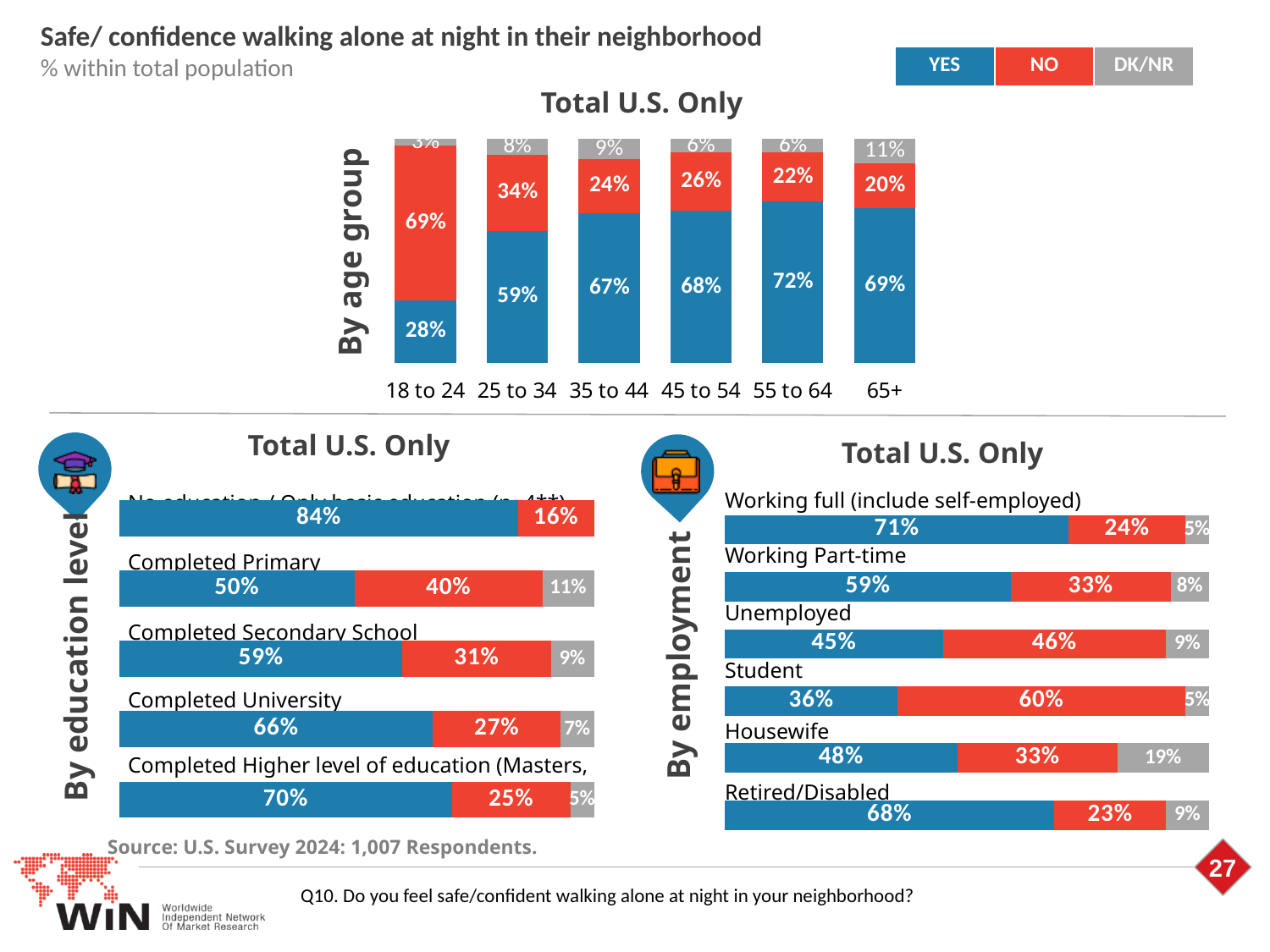
In the 'By education level' chart, which has the larger YES percentage: Completed Primary or Completed Secondary School? Completed Secondary School In the 'By education level' chart, what percentage of those who Completed University answered YES? 66% In the 'By age group' chart, what percentage of the 18 to 24 age group answered NO? 69% In the 'By employment' chart, which employment category has the highest DK/NR percentage? Housewife What kind of chart is the 'By age group' chart? Stacked bar chart How many series does the legend at the top of the slide list? 3 In the 'By age group' chart, which age group has the highest YES percentage? 55 to 64 In the 'By employment' chart, what is the difference between the YES percentage for Working full (include self-employed) and Working Part-time? 12 percentage points In the 'By employment' chart, what percentage of Students answered NO? 60% In the 'By age group' chart, which age group has the lowest YES percentage? 18 to 24 How many age groups are shown in the 'By age group' chart? 6 In the 'By age group' chart, what percentage of the 55 to 64 age group answered YES? 72%